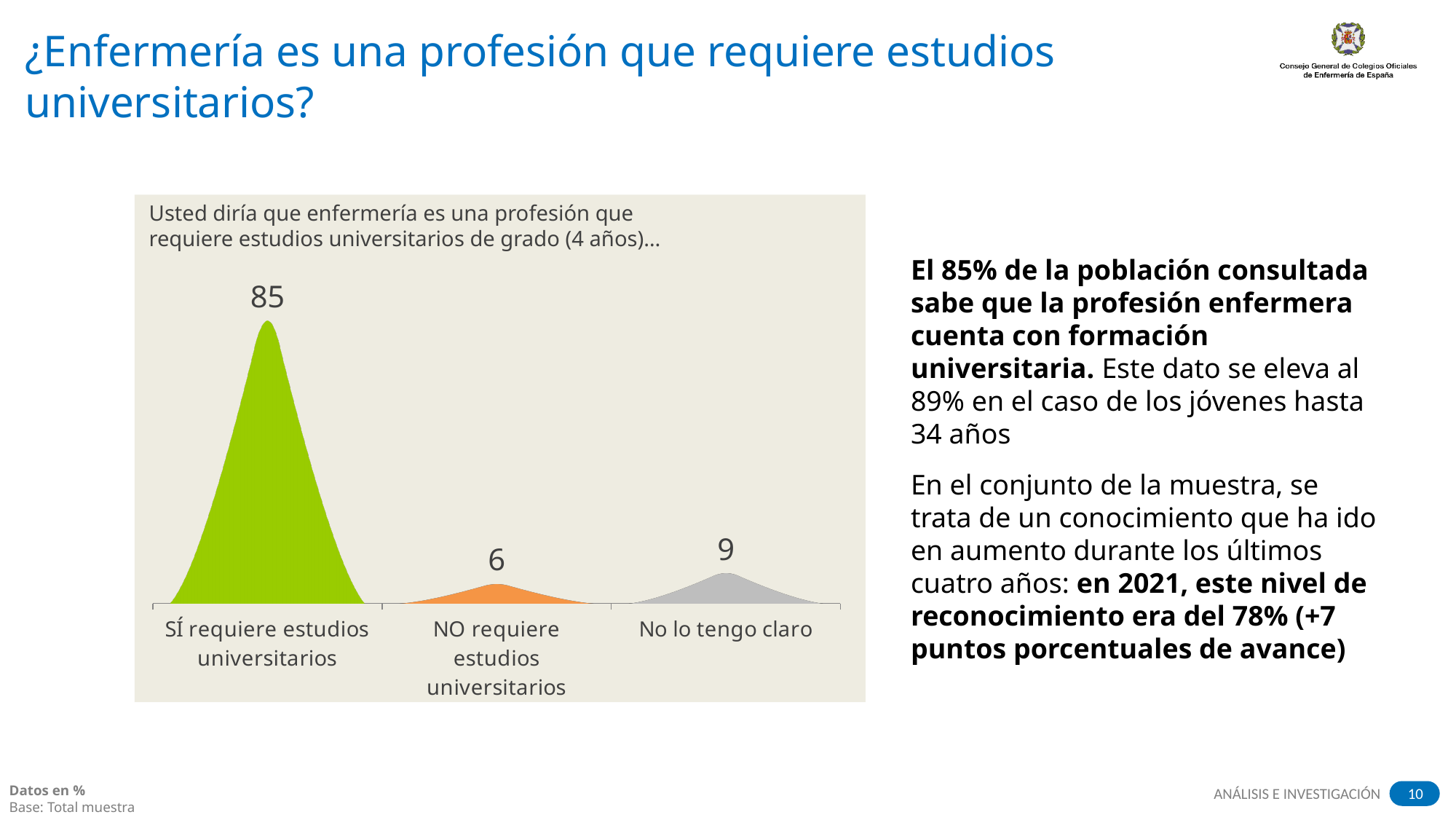
What colour is the shape for "SÍ requiere estudios universitarios"? Green What is the total of the three values shown in the chart? 100 What is the difference between the values for "No lo tengo claro" and "NO requiere estudios universitarios"? 3 What is the difference between the values for "SÍ requiere estudios universitarios" and "No lo tengo claro"? 76 What is the value for "SÍ requiere estudios universitarios"? 85 Which category has the lowest value? NO requiere estudios universitarios What question text appears at the top of the chart? Usted diría que enfermería es una profesión que requiere estudios universitarios de grado (4 años)… Which is larger: the value for "No lo tengo claro" or the value for "NO requiere estudios universitarios"? No lo tengo claro Which category has the highest value? SÍ requiere estudios universitarios What is the value for "NO requiere estudios universitarios"? 6 How many categories are shown in the chart? 3 What is the value for "No lo tengo claro"? 9